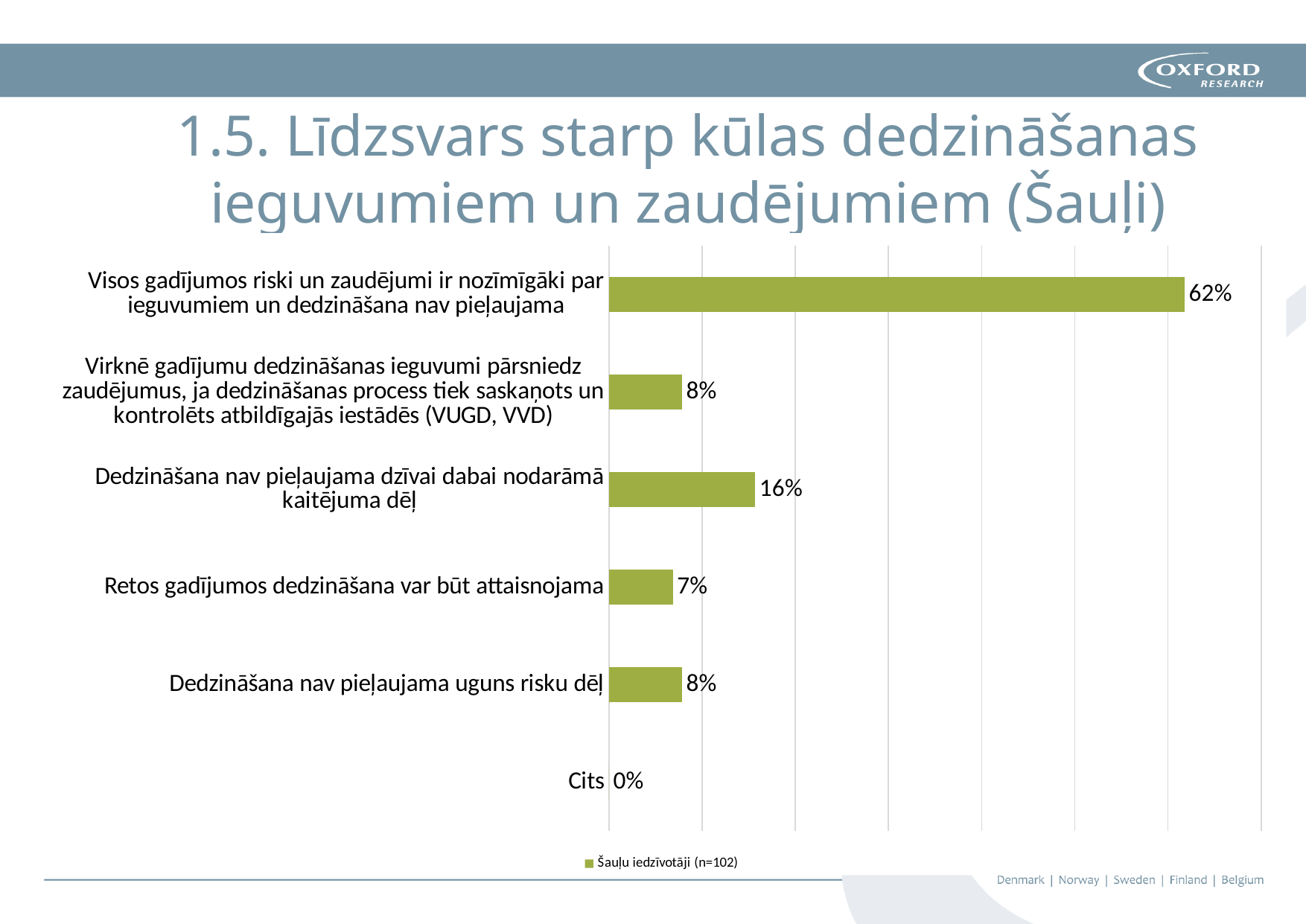
What is the value for "Dedzināšana nav pieļaujama dzīvai dabai nodarāmā kaitējuma dēļ"? 16% What is the value for "Retos gadījumos dedzināšana var būt attaisnojama"? 7% Which category has the highest value? Visos gadījumos riski un zaudējumi ir nozīmīgāki par ieguvumiem un dedzināšana nav pieļaujama What is the value for "Dedzināšana nav pieļaujama uguns risku dēļ"? 8% Which is larger: the value for "Dedzināšana nav pieļaujama dzīvai dabai nodarāmā kaitējuma dēļ" or the value for "Retos gadījumos dedzināšana var būt attaisnojama"? Dedzināšana nav pieļaujama dzīvai dabai nodarāmā kaitējuma dēļ What kind of chart is shown on the slide? bar chart What series does the legend list? Šauļu iedzīvotāji (n=102) Which category has the lowest value? Cits What is the value for "Cits"? 0% What is the difference between the value for "Visos gadījumos riski un zaudējumi ir nozīmīgāki par ieguvumiem un dedzināšana nav pieļaujama" and the value for "Dedzināšana nav pieļaujama dzīvai dabai nodarāmā kaitējuma dēļ"? 46% What is the value for "Visos gadījumos riski un zaudējumi ir nozīmīgāki par ieguvumiem un dedzināšana nav pieļaujama"? 62% How many categories are shown in the chart? 6